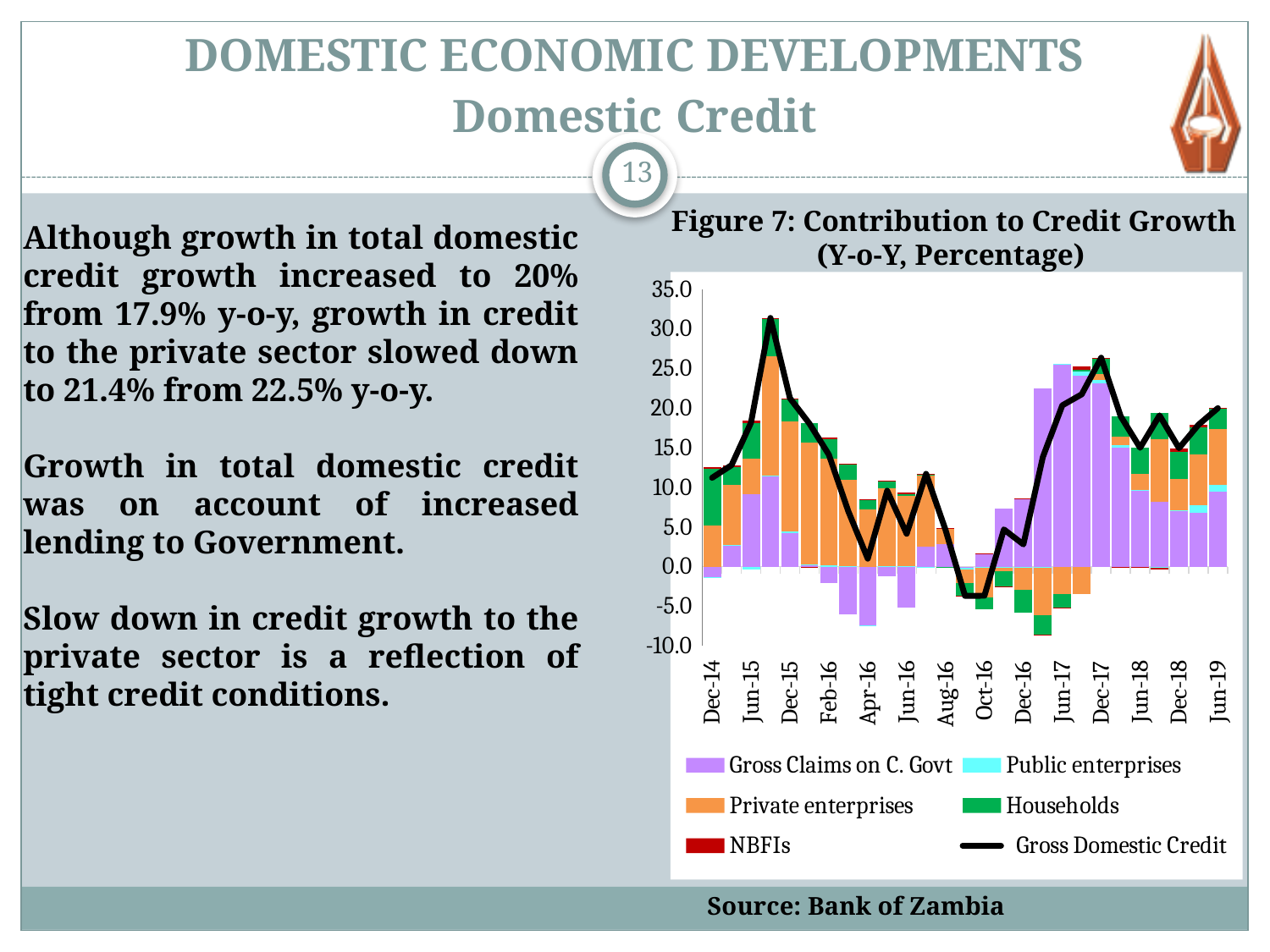
Does the Gross Domestic Credit line rise or fall between Jun-15 and Apr-16? Fall Is the Gross Domestic Credit value at Oct-16 greater or less than 0.0? less Which series in Figure 7 is drawn as a black line? Gross Domestic Credit Is the Gross Domestic Credit value at Dec-17 greater or less than 20.0? greater How many entries does the legend of Figure 7 list? 6 What is the title of the chart on the slide? Figure 7: Contribution to Credit Growth (Y-o-Y, Percentage) Which is larger, the Gross Domestic Credit value at Jun-15 or at Dec-17? Dec-17 Is the Gross Domestic Credit value at Jun-15 greater or less than 25.0? less What kind of chart is Figure 7? A stacked bar chart with a line At which labelled date does the Gross Domestic Credit line reach its lowest point? Oct-16